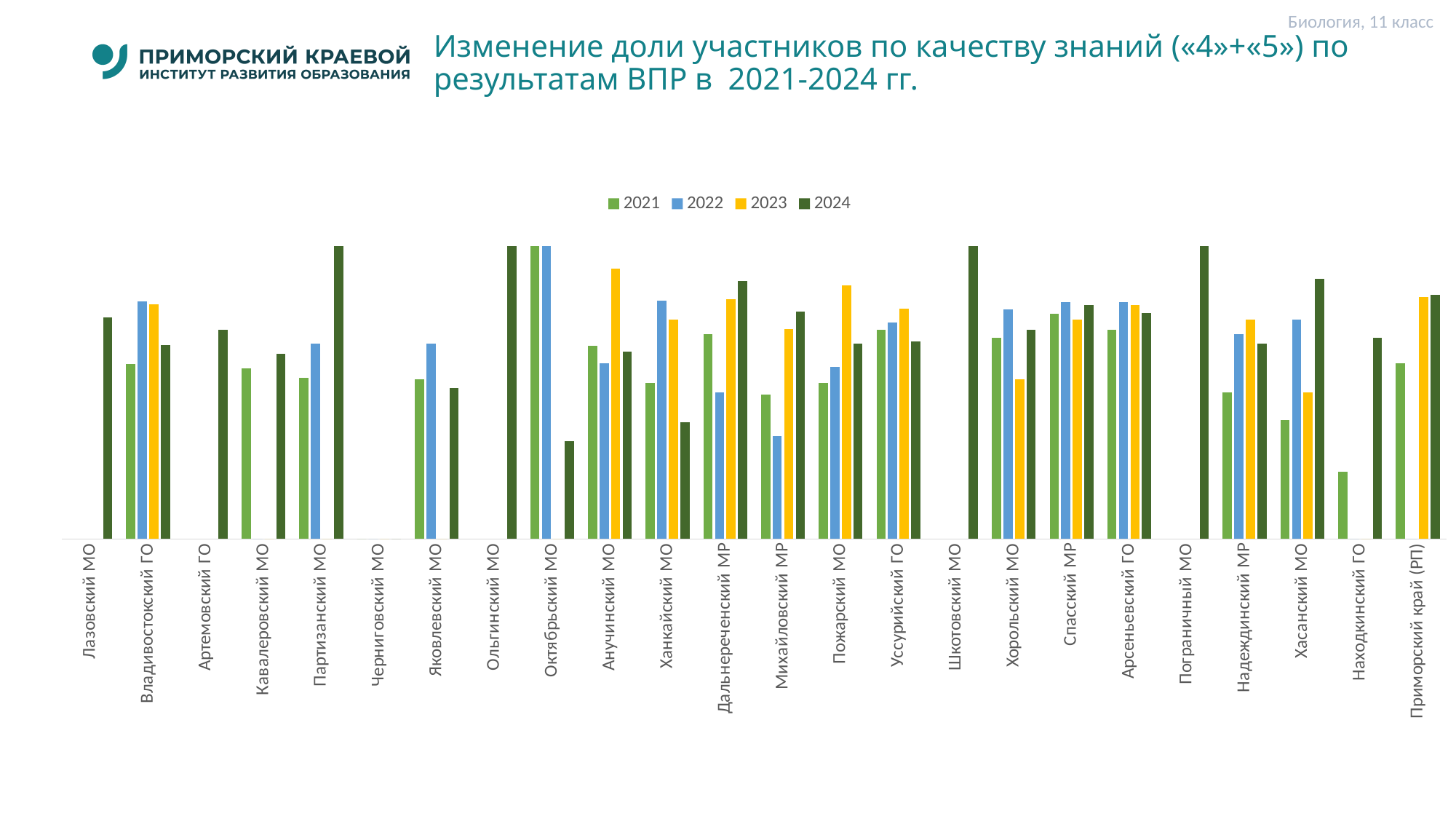
For Хасанский МО, which is larger: the 2021 value or the 2024 value? 2024 For Октябрьский МО, which year has the lowest bar? 2024 For Партизанский МО, which is larger: the 2021 value or the 2024 value? 2024 How many series does the legend list? 4 For Надеждинский МР, which year has the lowest bar? 2021 How many categories (municipalities) are shown along the x axis? 24 For Анучинский МО, which year has the highest bar? 2023 For Пожарский МО, which year has the highest bar? 2023 Which colour represents the 2023 series? yellow For Михайловский МР, which year has the lowest bar? 2022 What kind of chart is shown on the slide? bar chart Which years are listed in the legend? 2021, 2022, 2023, 2024